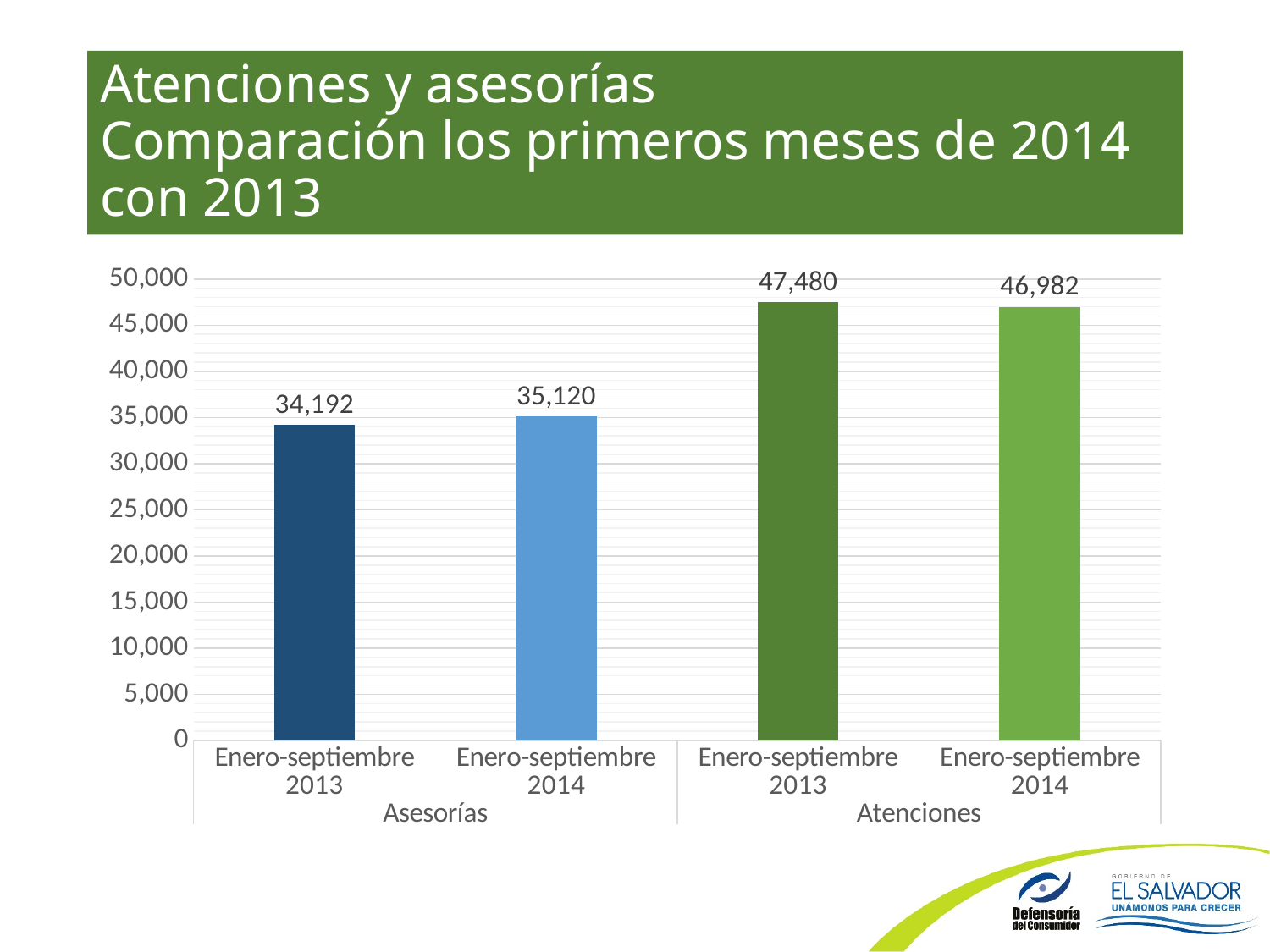
What is the difference between Asesorías in Enero-septiembre 2014 and Enero-septiembre 2013? 928 Which is larger: Atenciones in Enero-septiembre 2013 or Atenciones in Enero-septiembre 2014? Atenciones in Enero-septiembre 2013 What is the value for Asesorías, Enero-septiembre 2013? 34,192 What is the value for Asesorías, Enero-septiembre 2014? 35,120 What is the value for Atenciones, Enero-septiembre 2014? 46,982 Which bar has the highest value? Atenciones, Enero-septiembre 2013 What kind of chart is shown on the slide? bar chart What is the difference between Atenciones in Enero-septiembre 2013 and Enero-septiembre 2014? 498 How many bars are plotted in the chart? 4 Which bar has the lowest value? Asesorías, Enero-septiembre 2013 What is the value for Atenciones, Enero-septiembre 2013? 47,480 Is the value for Asesorías, Enero-septiembre 2014 greater or less than 40,000? less